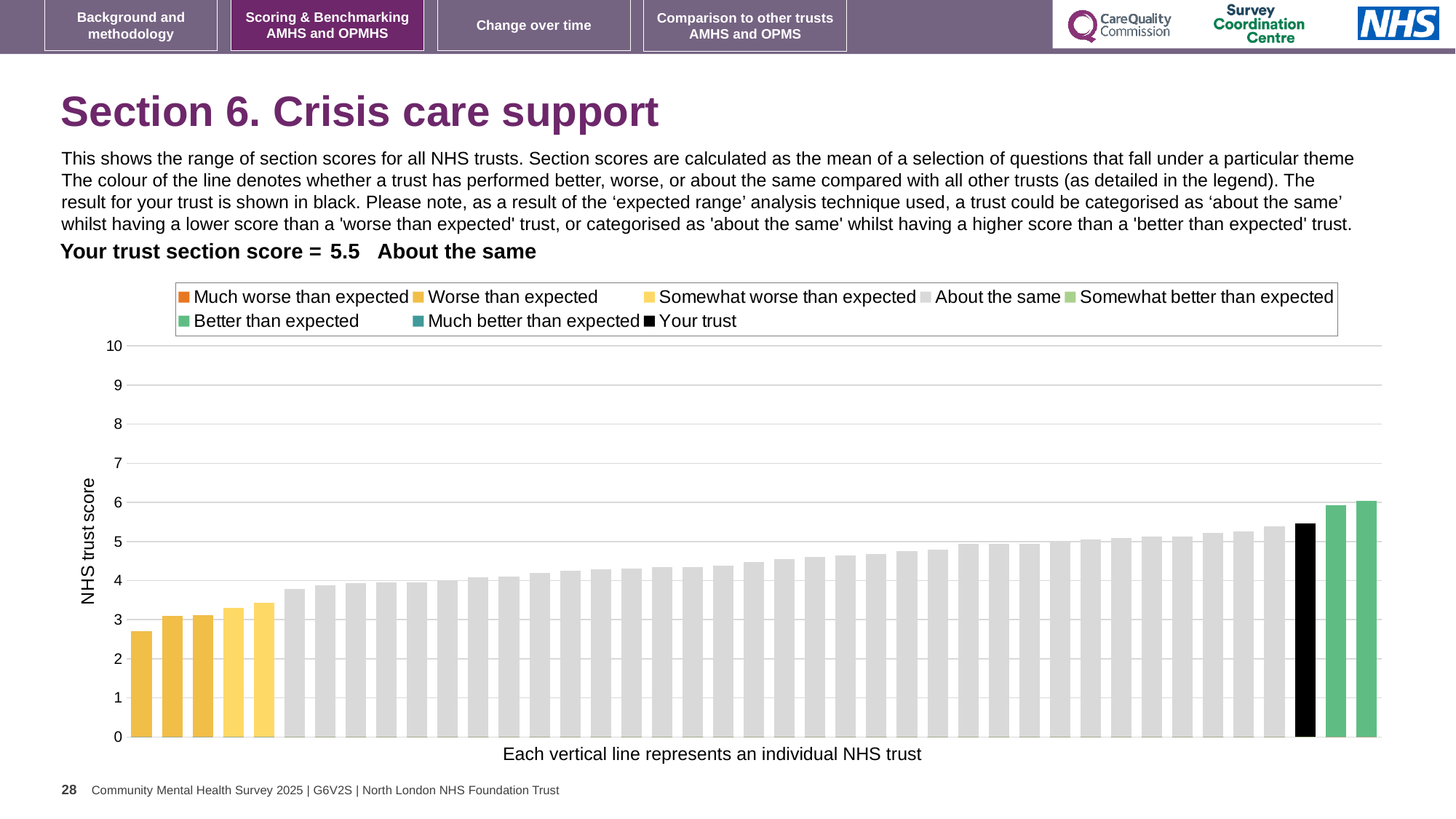
Is the value of the highest bar greater or less than 5? greater How many trusts are shown as 'Better than expected' (green bars)? 2 What kind of chart is shown on the slide? bar chart What is the section score for your trust shown on the slide? 5.5 How many trusts are shown as 'Worse than expected' (dark yellow bars)? 3 Is the value of the lowest bar greater or less than 3? less Which is larger: your trust's score (black bar) or the lowest bar on the chart? your trust's score How many entries does the chart legend list? 8 Which category is your trust's section score placed in? About the same Do the bar values rise or fall from left to right along the x axis? rise Is your trust's score greater or less than 5? greater What is the label on the vertical axis of the chart? NHS trust score